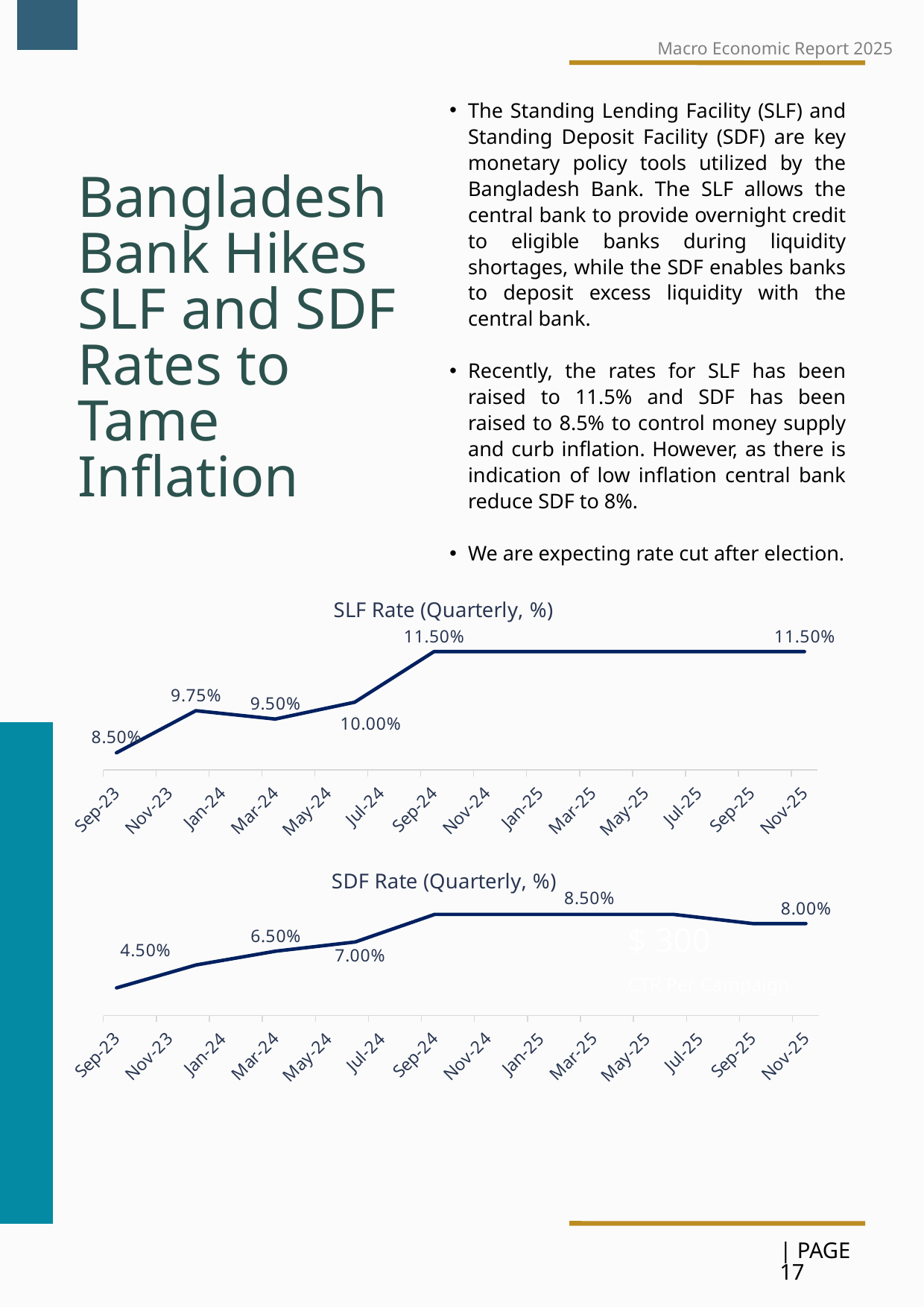
In the SDF Rate (Quarterly, %) chart, which is larger: the value for Sep-23 or the value for Nov-25? Nov-25 How many date labels are shown on the x axis of the SDF Rate (Quarterly, %) chart? 14 In the SLF Rate (Quarterly, %) chart, what is the highest value shown? 11.50% In the SDF Rate (Quarterly, %) chart, what is the lowest value shown? 4.50% In the SDF Rate (Quarterly, %) chart, what is the value for Sep-23? 4.50% In the SDF Rate (Quarterly, %) chart, what is the value for Nov-25? 8.00% In the SLF Rate (Quarterly, %) chart, what is the value for Sep-23? 8.50% In the SLF Rate (Quarterly, %) chart, what is the difference between the Nov-25 value and the Sep-23 value? 3.00% In the SLF Rate (Quarterly, %) chart, what is the value for Nov-25? 11.50% In the SLF Rate (Quarterly, %) chart, does the line generally rise or fall from Sep-23 to Sep-24? rise What kind of chart is the SLF Rate (Quarterly, %) chart? line chart